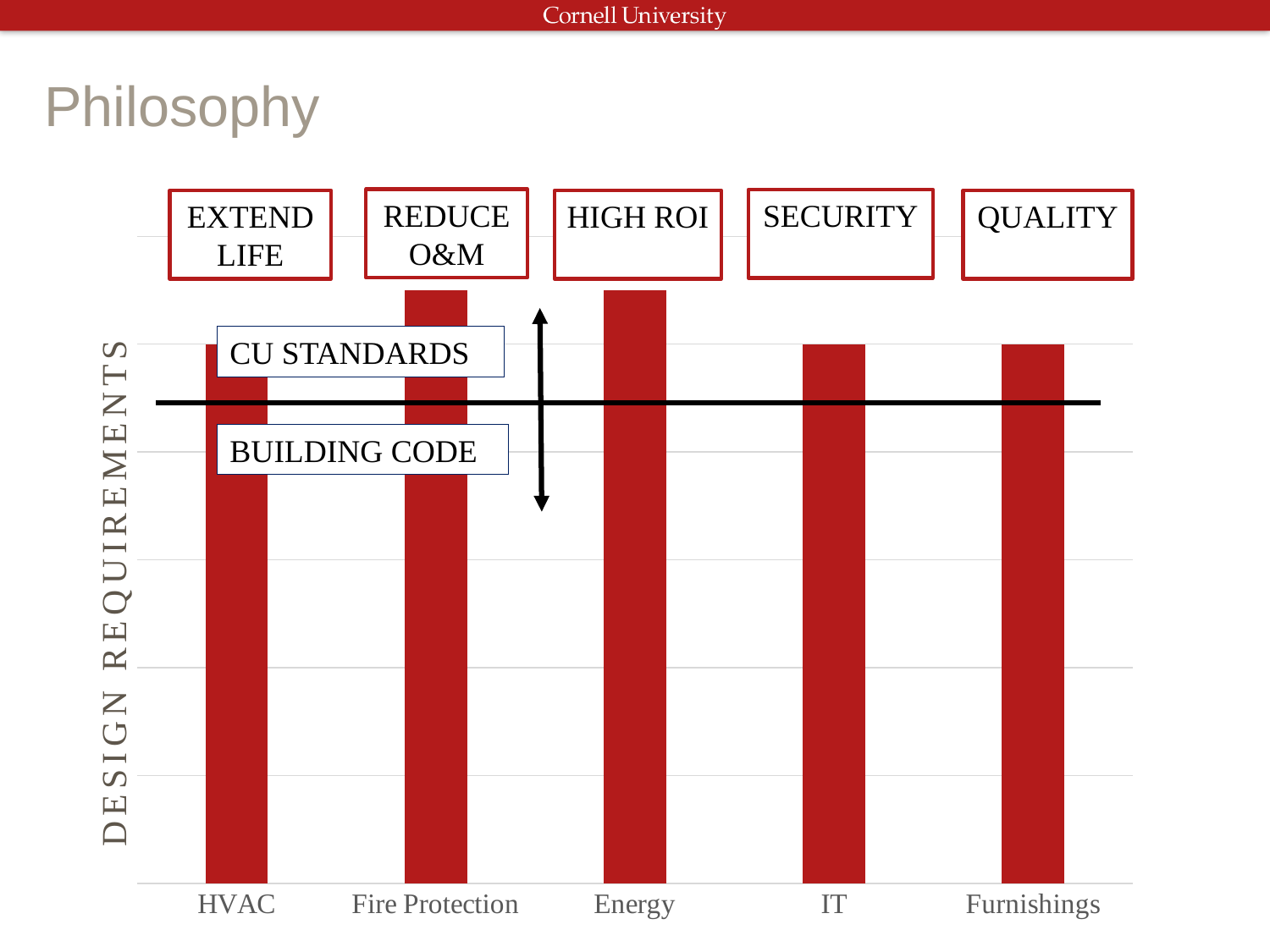
Which bar is taller, HVAC or Energy? Energy Which bar is taller, Fire Protection or IT? Fire Protection What is the label on the vertical axis of the chart? DESIGN REQUIREMENTS Which category is plotted last on the x axis of the chart? Furnishings Which bar is shorter, Fire Protection or HVAC? HVAC What kind of chart is shown on the slide? Bar chart Which category is plotted first on the x axis of the chart? HVAC How many categories are plotted on the x axis of the chart? 5